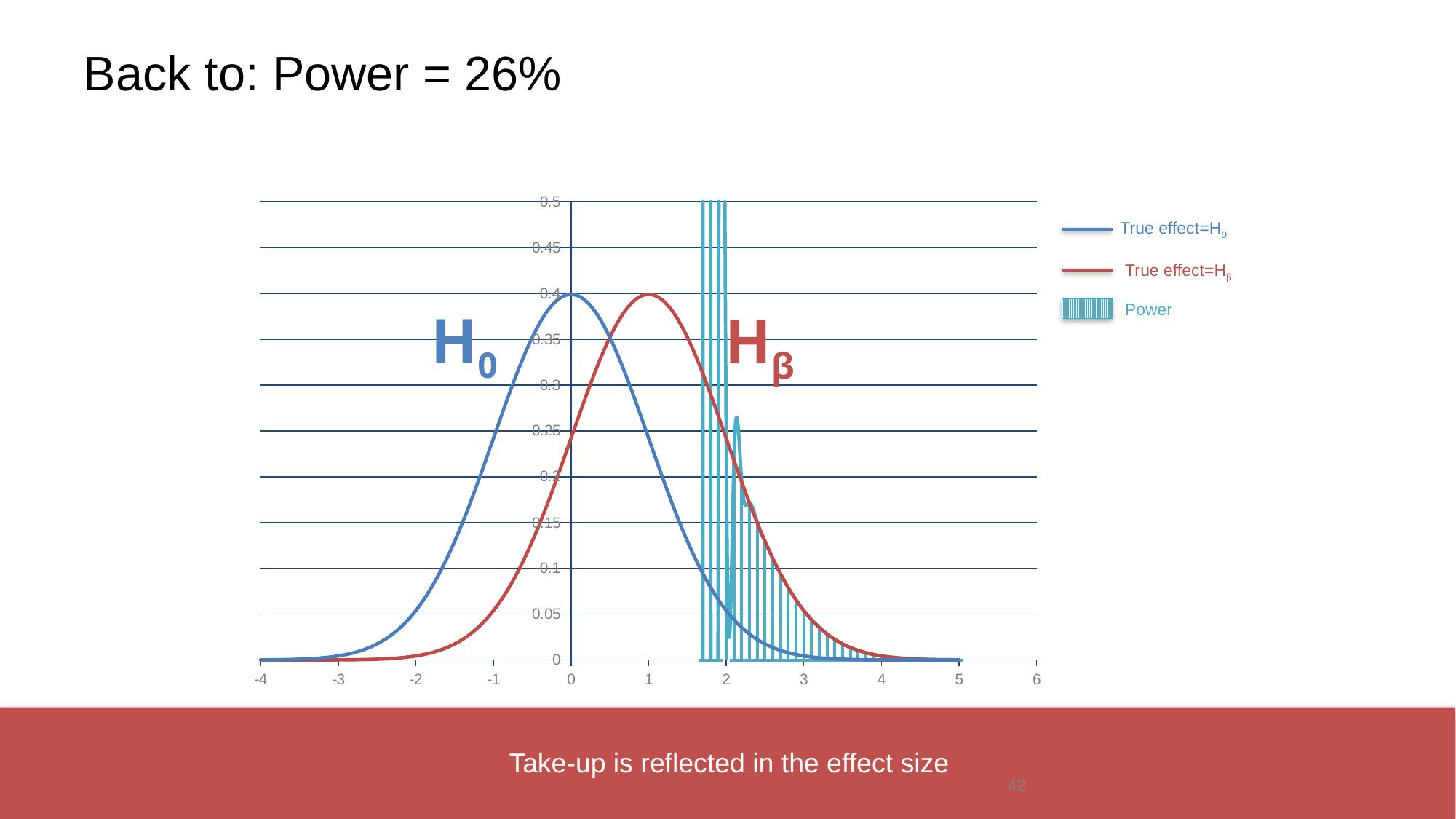
Is the value of the red Hβ curve at x = 0 greater or less than 0.3? less Which curve peaks further to the right on the x axis, the blue H0 curve or the red Hβ curve? the red Hβ curve At which x-axis value does the red Hβ curve reach its peak? 1 Does the red Hβ curve rise or fall as x increases from -4 to 1? rise How many series does the legend list? 3 At which x-axis value does the blue H0 curve reach its peak? 0 What are the three entries in the chart legend? True effect=H0, True effect=Hβ, Power What kind of chart is shown on the slide? line chart What is the title of the slide containing the chart? Back to: Power = 26% Is the value of the blue H0 curve at x = 2 greater or less than 0.1? less Does the blue H0 curve rise or fall as x increases from 0 to 4? fall Is the peak value of the blue H0 curve greater or less than 0.35? greater